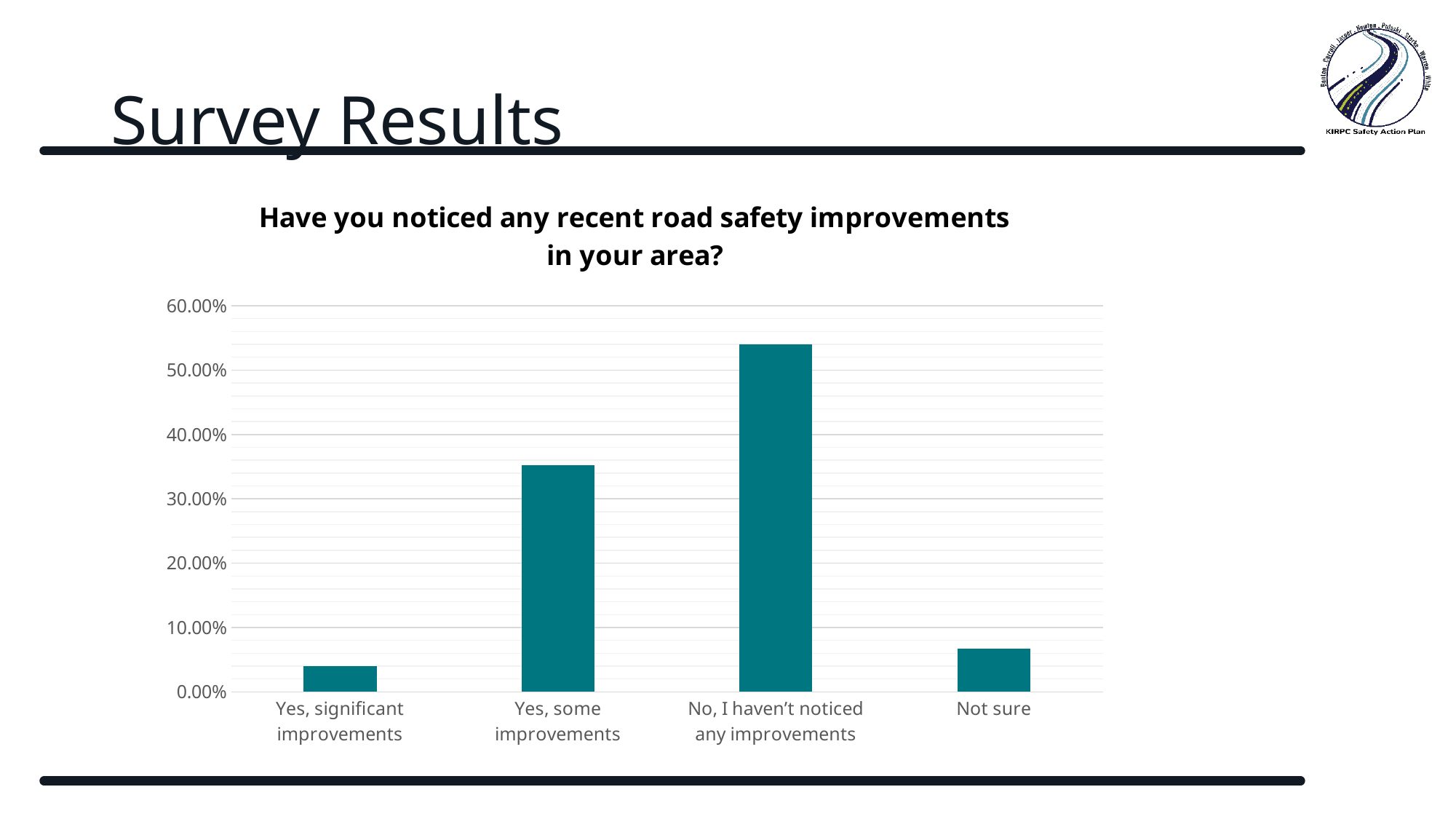
Is the value for "Not sure" greater or less than 10.00%? less Which response category has the lowest value? Yes, significant improvements Is the value for "Yes, some improvements" greater or less than 30.00%? greater What is the title of the chart? Have you noticed any recent road safety improvements in your area? Is the value for "No, I haven't noticed any improvements" greater or less than 50.00%? greater What is the highest value labelled on the y axis? 60.00% Which response category has the highest value? No, I haven't noticed any improvements Which is larger, the value for "Not sure" or the value for "Yes, significant improvements"? Not sure How many response categories are shown on the x axis? 4 What kind of chart is shown on the slide? bar chart Which is larger, the value for "Yes, some improvements" or the value for "Not sure"? Yes, some improvements